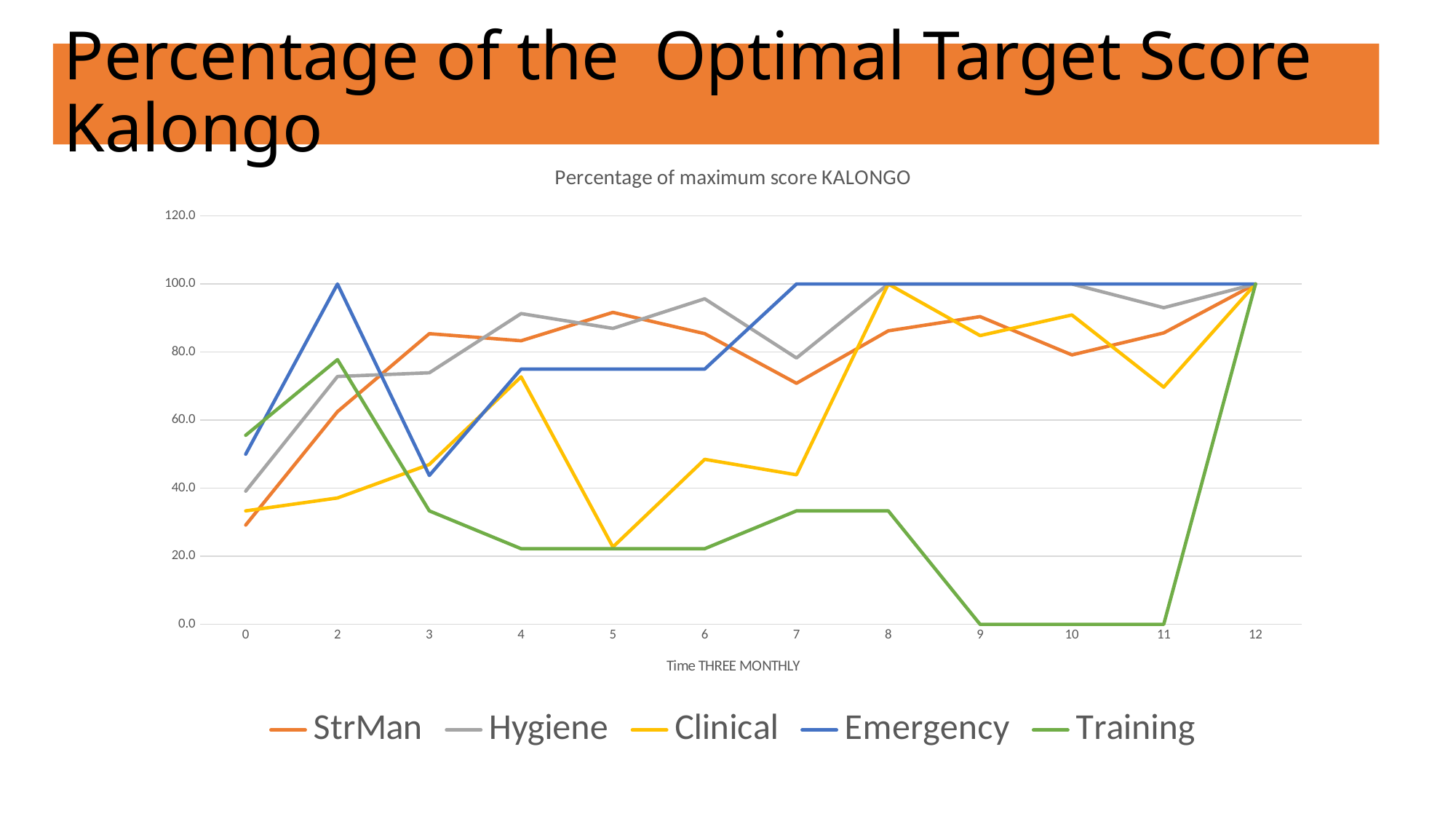
Which series has the lowest value at time 10? Training At time 7, which is larger, the value for Emergency or the value for Clinical? Emergency Which series has the highest value at time 2? Emergency What is the title of the x axis? Time THREE MONTHLY How many time points are plotted along the x axis? 12 Is the value for Clinical at time 5 greater or less than 40? less How many series does the legend list? 5 What is the value for Training at time 9? 0.0 Is the value for Hygiene at time 6 greater or less than 80? greater What is the value for Clinical at time 12? 100.0 What kind of chart is shown on the slide? line chart What is the value for Emergency at time 2? 100.0